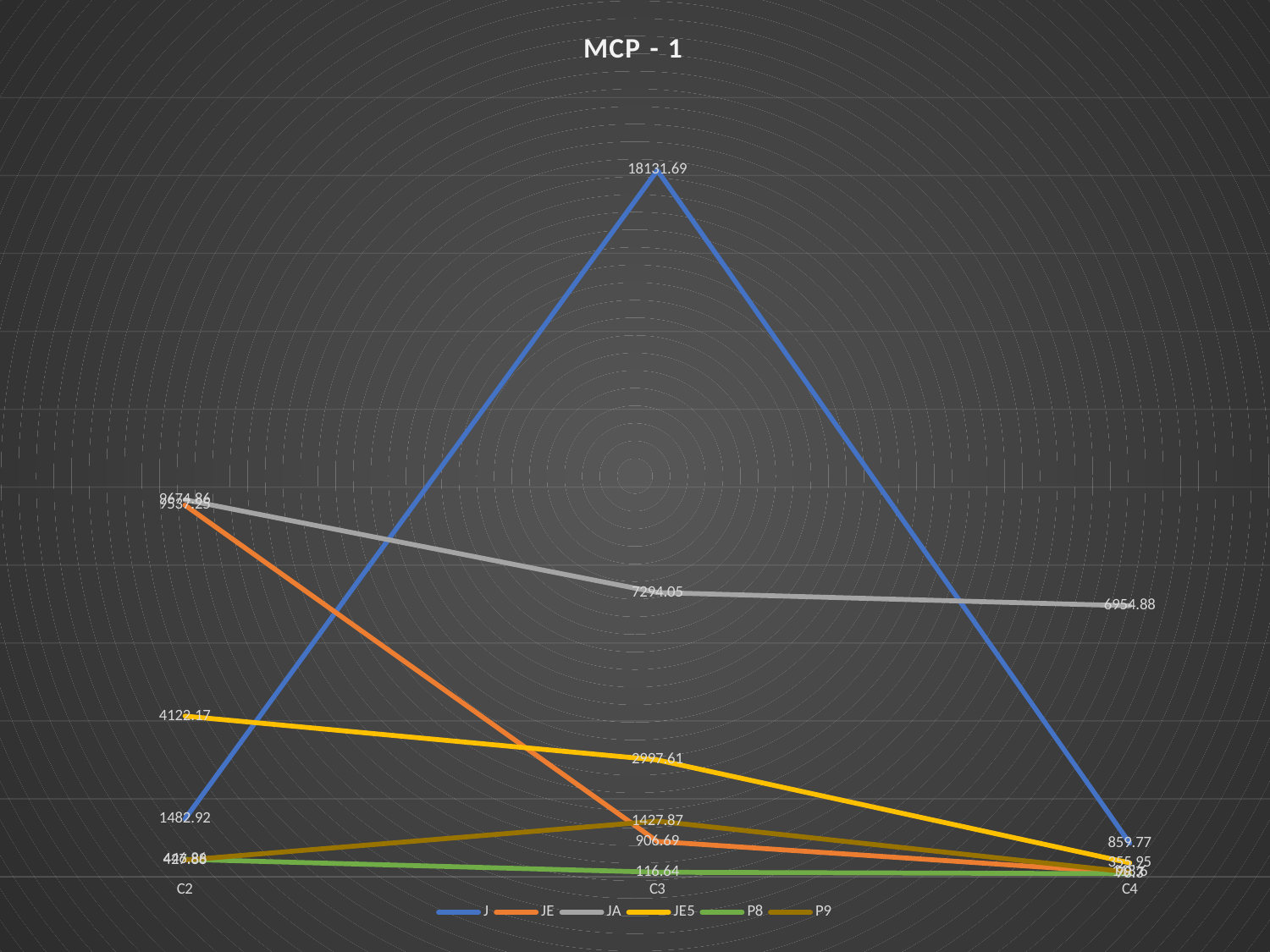
What is the value of series J at C3? 18131.69 What type of chart is shown on the slide? line chart What is the title of the chart? MCP - 1 What is the value of series P8 at C3? 116.64 Does the JE5 series rise or fall from C2 to C4? fall How many categories are shown on the x axis? 3 Which is larger: the value of J at C4 or the value of JE5 at C4? J at C4 What is the value of series JA at C4? 6954.88 Which series has the highest value at C3? J What is the difference between the JA values at C3 and C4? 339.17 What is the value of series JE5 at C3? 2997.61 How many series does the legend list? 6